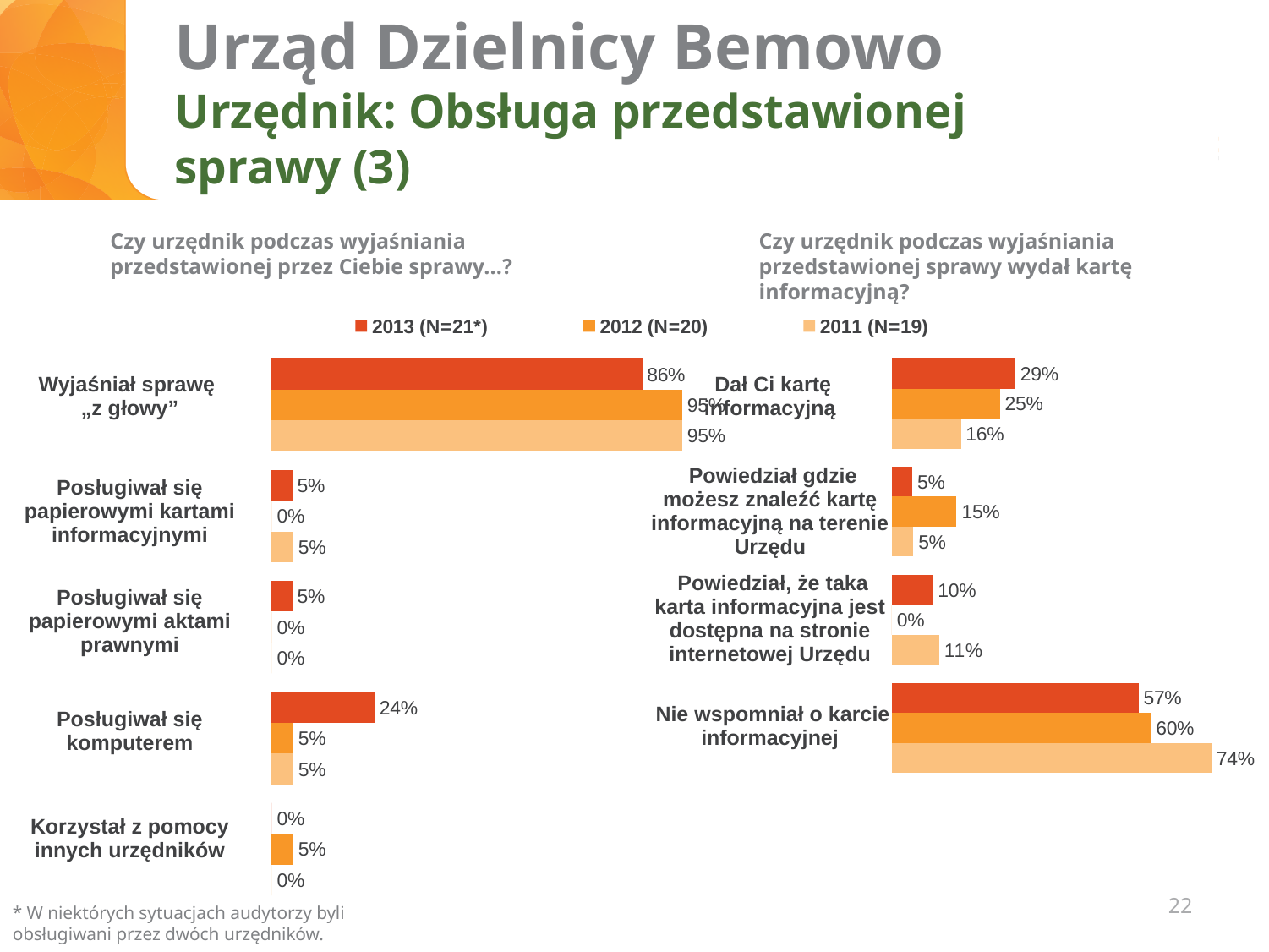
What type of chart is the right chart? Bar chart How many categories does the left chart show? 5 In the left chart, which category has the highest 2011 value? Wyjaśniał sprawę „z głowy” How many series does the legend list? 3 In the left chart, what is the 2013 value for "Wyjaśniał sprawę „z głowy”"? 86% In the left chart, what is the 2013 value for "Posługiwał się komputerem"? 24% In the right chart, what is the 2011 value for "Nie wspomniał o karcie informacyjnej"? 74% In the right chart, what is the 2012 value for "Powiedział gdzie możesz znaleźć kartę informacyjną na terenie Urzędu"? 15% In the right chart, which category has the highest 2013 value? Nie wspomniał o karcie informacyjnej In the left chart, what is the difference between the 2013 and 2012 values for "Posługiwał się komputerem"? 19 percentage points In the right chart, for "Dał Ci kartę informacyjną", which year has the larger value: 2013 or 2011? 2013 In the right chart, what is the difference between the 2011 and 2013 values for "Nie wspomniał o karcie informacyjnej"? 17 percentage points